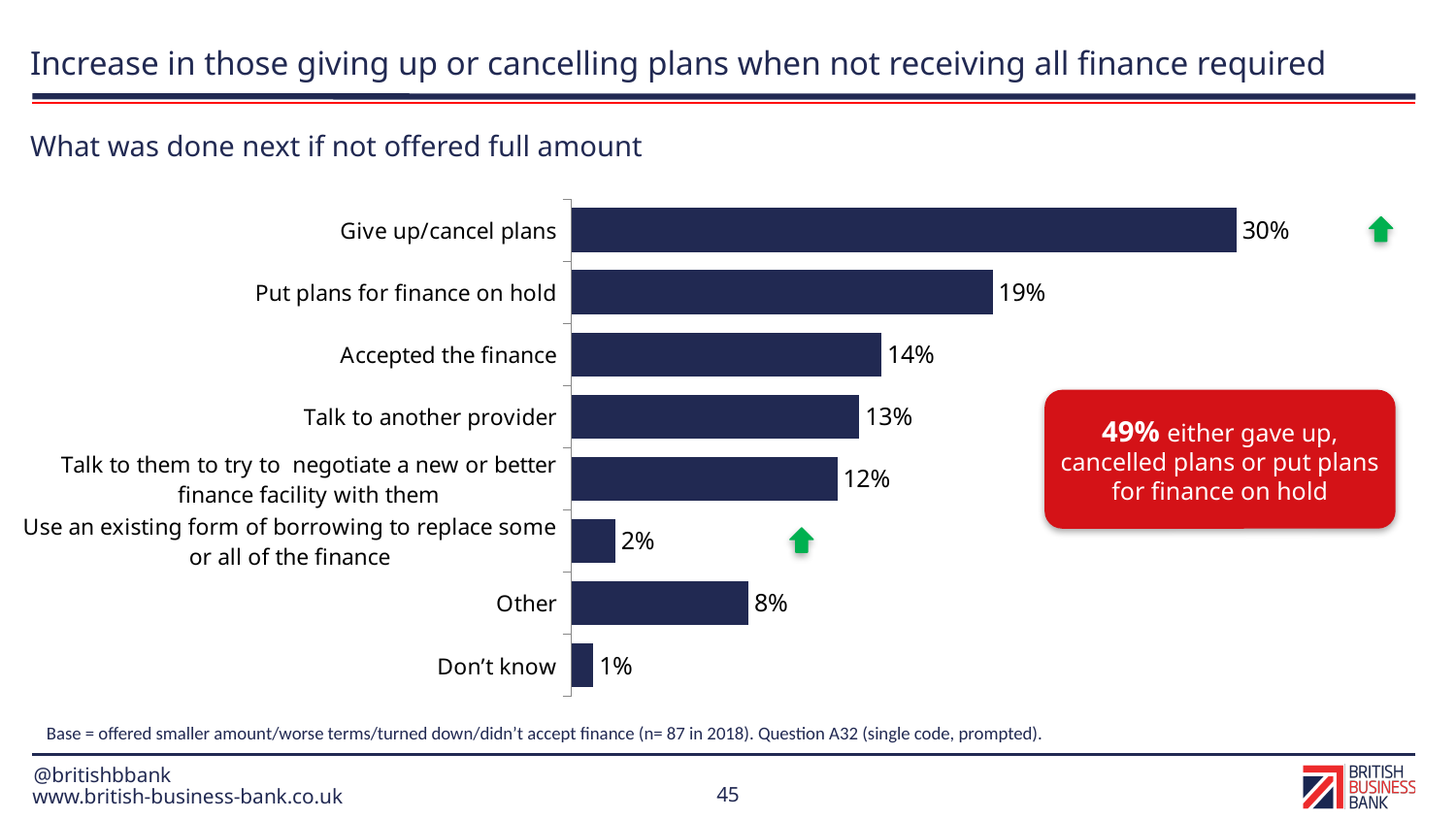
What percentage accepted the finance? 14% What is the difference between 'Give up/cancel plans' and 'Put plans for finance on hold'? 11 percentage points What percentage of respondents said they would give up or cancel plans? 30% Which is larger: 'Talk to another provider' or 'Other'? Talk to another provider Which category has the highest value? Give up/cancel plans What is the value for 'Use an existing form of borrowing to replace some or all of the finance'? 2% Which category has the lowest value? Don't know What kind of chart is shown on the slide? Bar chart What is the value for 'Put plans for finance on hold'? 19% How many categories are shown in the chart? 8 What is the title of the chart? What was done next if not offered full amount What is the combined value of 'Give up/cancel plans' and 'Put plans for finance on hold'? 49%